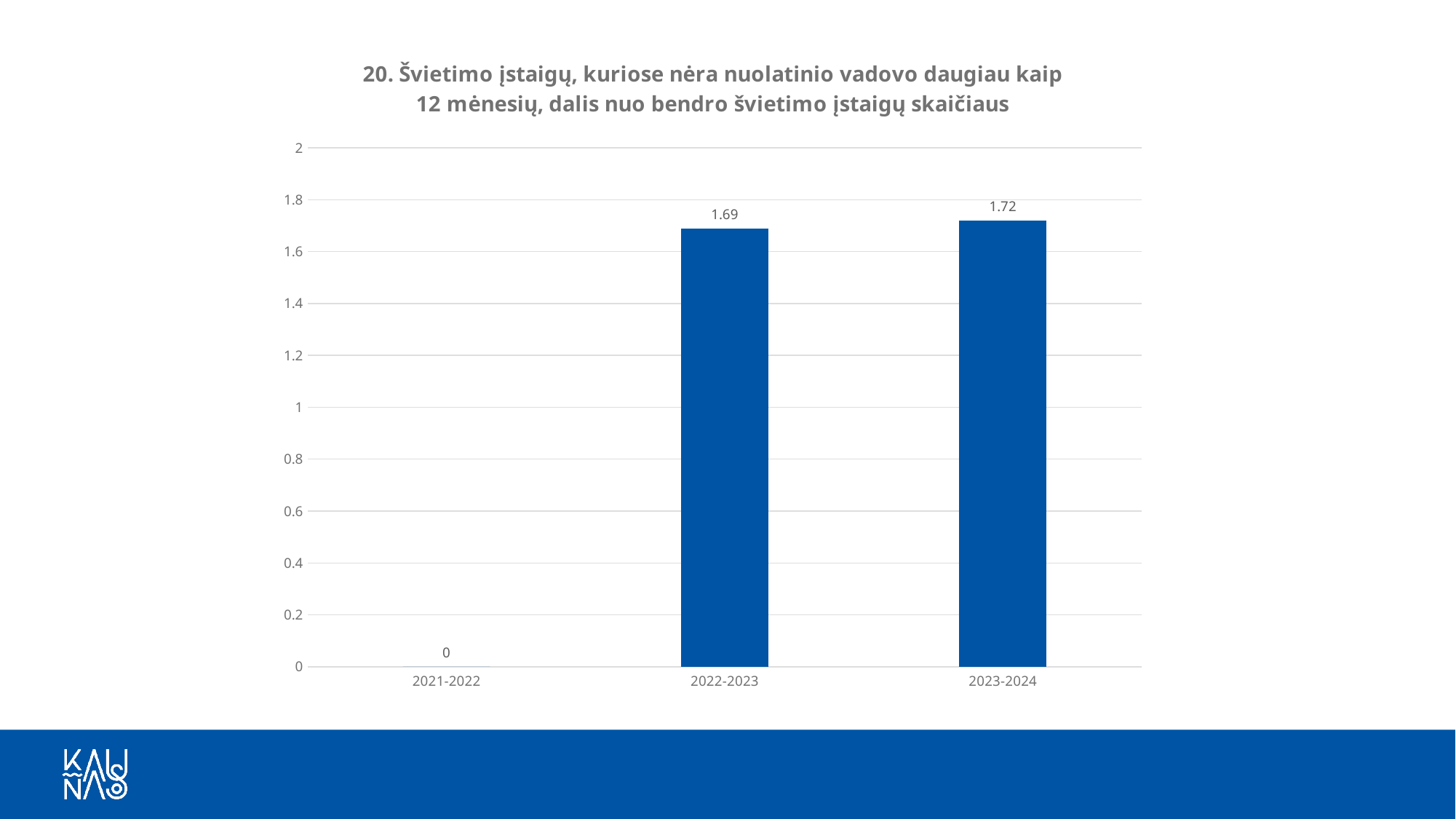
Is the value for 2023-2024 greater or less than 1.8? less Which is larger, the value for 2022-2023 or the value for 2021-2022? 2022-2023 What is the difference between the values for 2023-2024 and 2022-2023? 0.03 What is the value for 2023-2024? 1.72 Do the values rise or fall from 2021-2022 to 2023-2024? rise How many categories are shown on the x axis? 3 What is the value for 2022-2023? 1.69 What is the value for 2021-2022? 0 What kind of chart is shown on the slide? bar chart Which category has the highest value? 2023-2024 Which category has the lowest value? 2021-2022 What is the maximum value shown on the vertical axis? 2